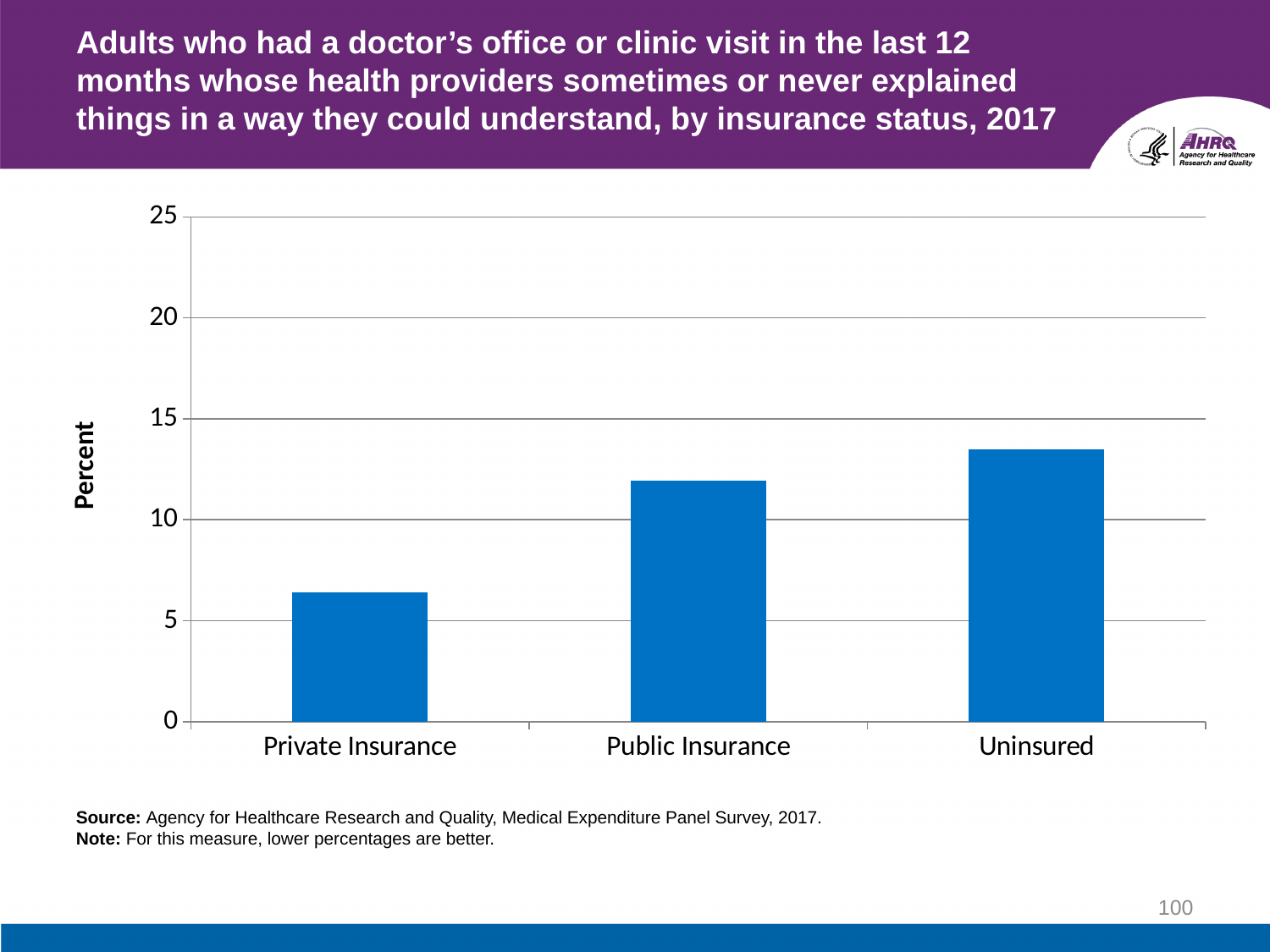
Which is larger, the value for Public Insurance or the value for Uninsured? Uninsured Do the values rise or fall moving from Private Insurance to Uninsured along the x axis? Rise What is the label on the vertical axis of the chart? Percent Is the value for Private Insurance greater or less than 5? greater Is the value for Private Insurance greater or less than 10? less Is the value for Public Insurance greater or less than 10? greater How many insurance status categories are plotted on the chart? 3 What kind of chart is shown on the slide? Bar chart Which insurance status category has the lowest percentage? Private Insurance Which is larger, the value for Private Insurance or the value for Public Insurance? Public Insurance Which insurance status category has the highest percentage? Uninsured